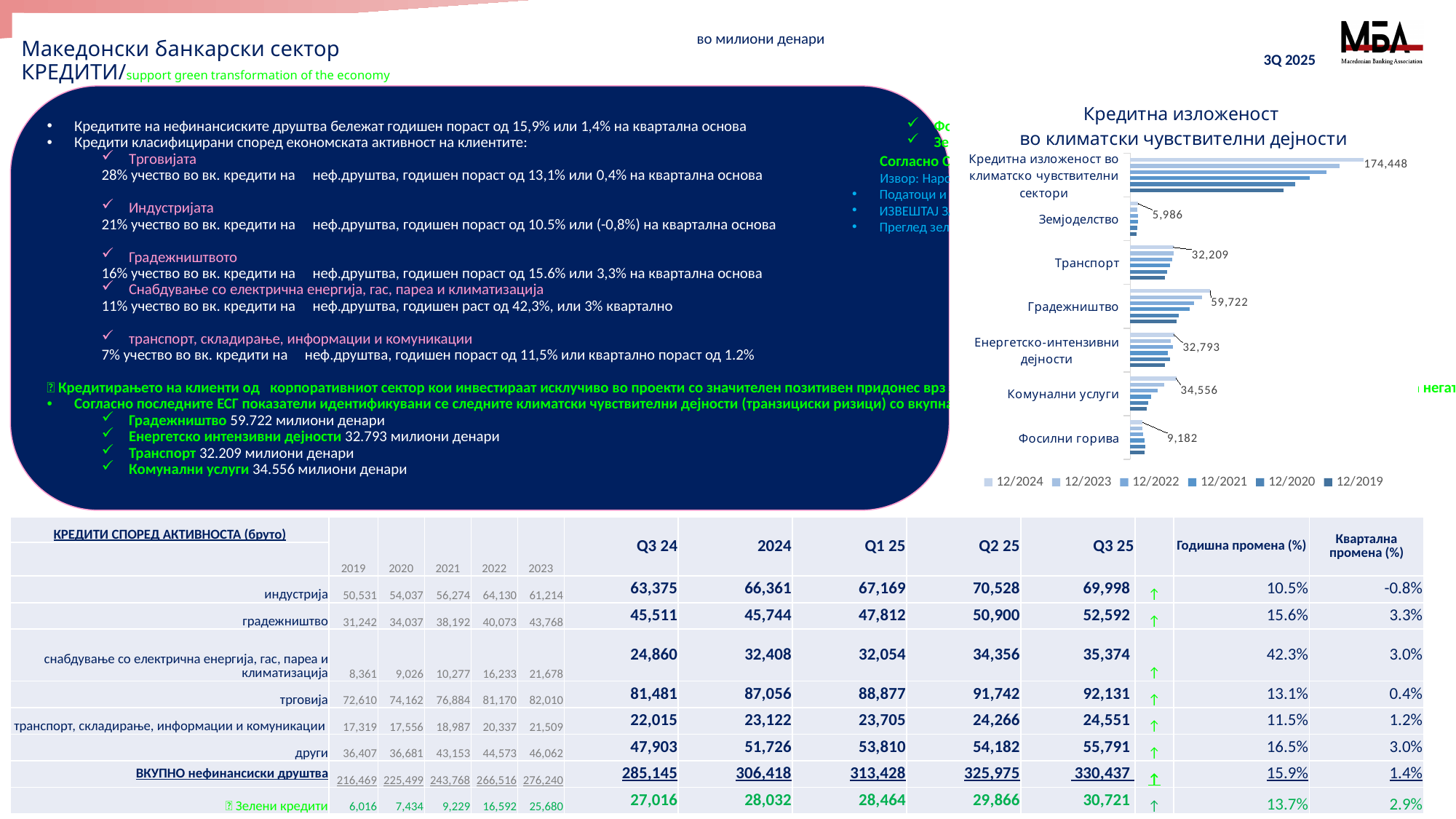
What is the title of the chart on the slide? Кредитна изложеност во климатски чувствителни дејности Which category has the lowest labelled value in the chart? Земјоделство How many series does the chart legend list? 6 What kind of chart is shown on the slide? bar chart What is the difference between the labelled values for Градежништво and Транспорт in the chart? 27,513 What is the labelled value for Земјоделство in the chart? 5,986 What is the labelled value for Градежништво in the chart? 59,722 How many categories are shown on the chart's vertical axis? 7 Which has the larger labelled value in the chart, Комунални услуги or Транспорт? Комунални услуги Among the individual sectors (excluding the aggregate category), which has the highest labelled value in the chart? Градежништво What is the labelled value for Фосилни горива in the chart? 9,182 What is the labelled value for Кредитна изложеност во климатско чувствителни сектори in the chart? 174,448